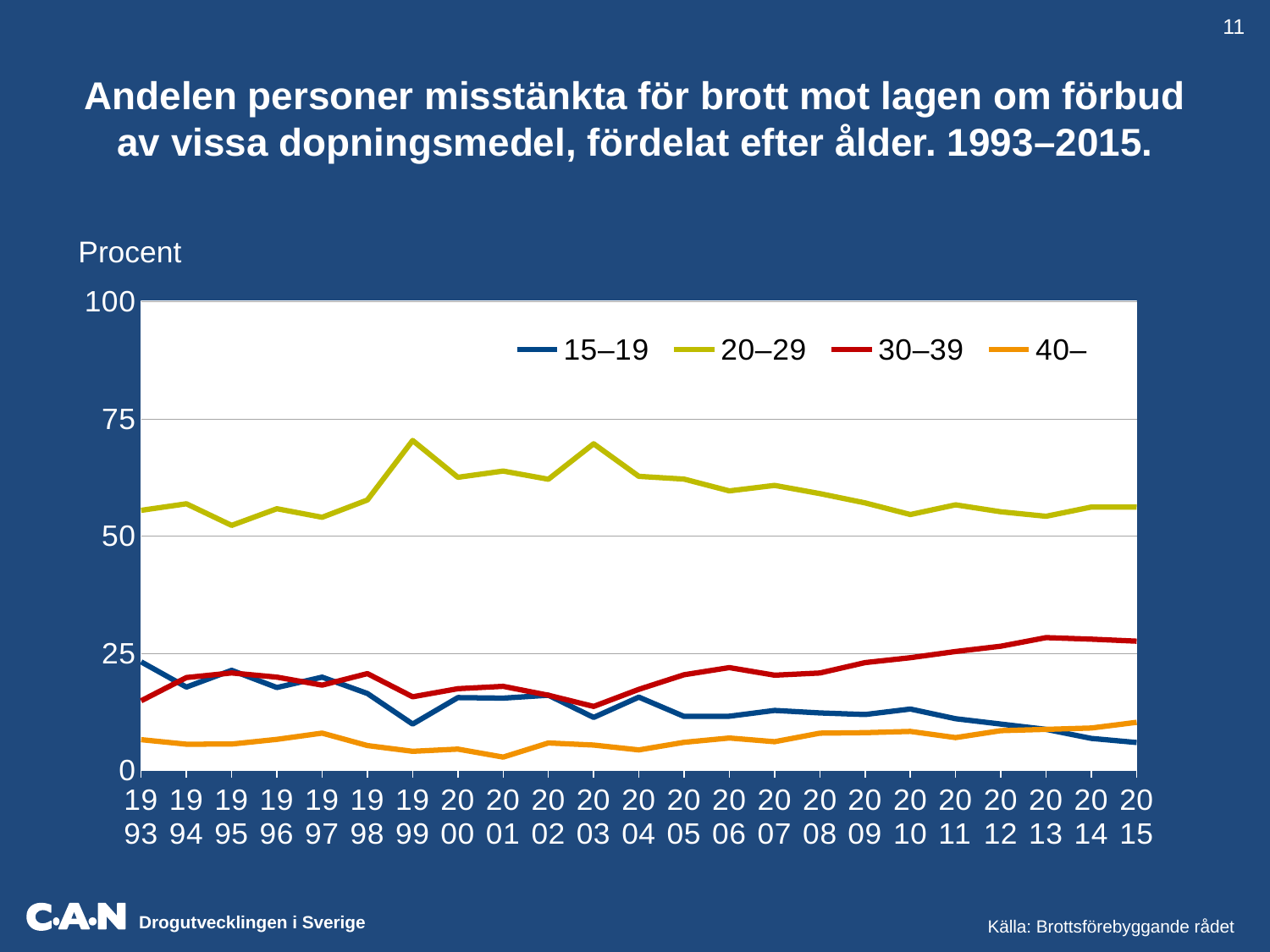
Which is larger in 2015, the value for 30–39 or the value for 15–19? 30–39 Is the value for the 15–19 group in 2015 greater or less than 25? less How many years are plotted along the x axis? 23 Which age group has the lowest share in 2001? 40– Which age group has the highest share in every year shown? 20–29 Which is larger in 1993, the value for 15–19 or the value for 30–39? 15–19 Does the 15–19 line rise or fall overall from 1993 to 2015? fall What kind of chart is shown on the slide? line chart Is the value for the 20–29 group in 1999 greater or less than 50? greater How many series does the legend list? 4 Is the value for the 40– group in 2001 greater or less than 25? less What label is shown on the y axis of the chart? Procent